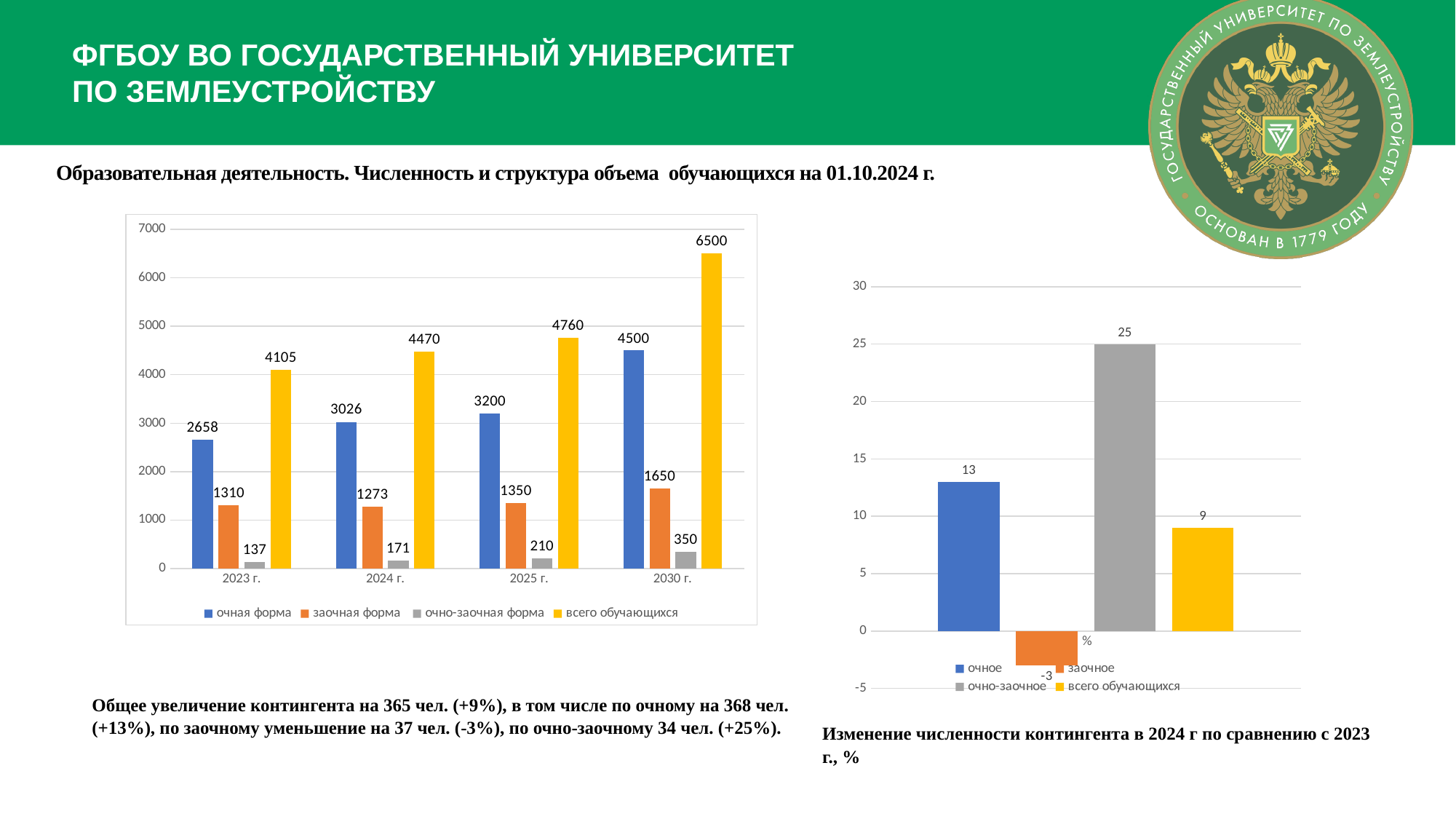
On the right chart, which category has the highest value? очно-заочное On the left chart, in which year is 'заочная форма' lowest? 2024 г. What kind of chart is the left chart? bar chart On the left chart, how many series does the legend list? 4 On the left chart, what is the value for 'очно-заочная форма' in 2025 г.? 210 On the right chart, what is the value for 'заочное'? -3 On the left chart, what is the value for 'очная форма' in 2024 г.? 3026 On the left chart, what is the difference between 'всего обучающихся' in 2024 г. and 2023 г.? 365 On the right chart, what is the value for 'очно-заочное'? 25 On the right chart, which is larger: 'очное' or 'всего обучающихся'? очное On the left chart, does 'всего обучающихся' rise or fall from 2023 г. to 2030 г.? rise On the left chart, what is the value for 'всего обучающихся' in 2030 г.? 6500